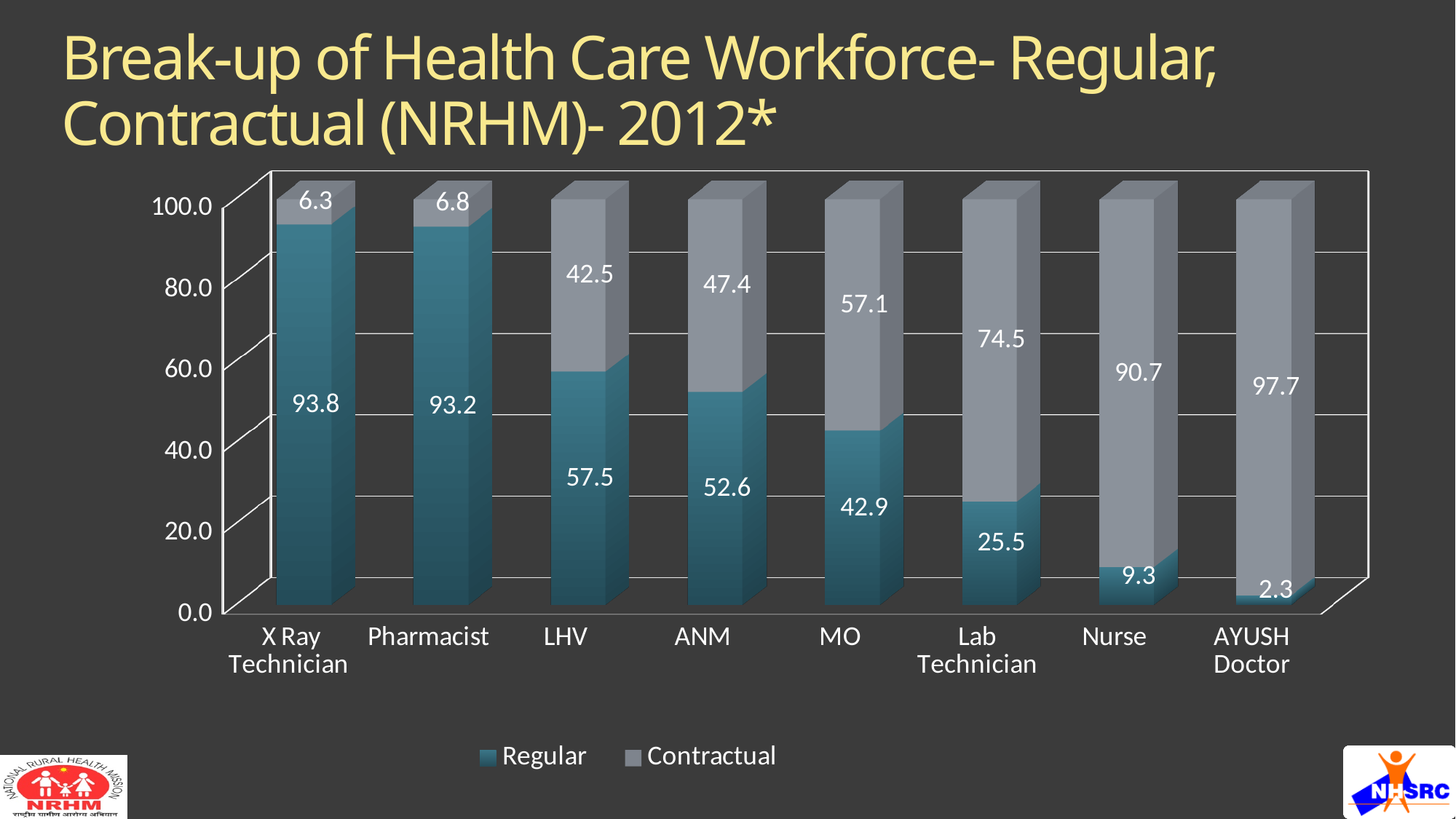
What kind of chart is shown on the slide? Stacked bar chart How many series does the legend list? 2 What is the total of the stacked bar for LHV? 100.0 What is the difference between the Regular and Contractual values for MO? 14.2 Which category has the lowest Regular value? AYUSH Doctor What is the Regular value for Pharmacist? 93.2 What is the Regular value for Nurse? 9.3 Which category has the highest Contractual value? AYUSH Doctor What is the Contractual value for Lab Technician? 74.5 Which is larger for ANM, the Regular value or the Contractual value? Regular Which series is shown in grey in the legend? Contractual How many categories are shown on the x axis? 8